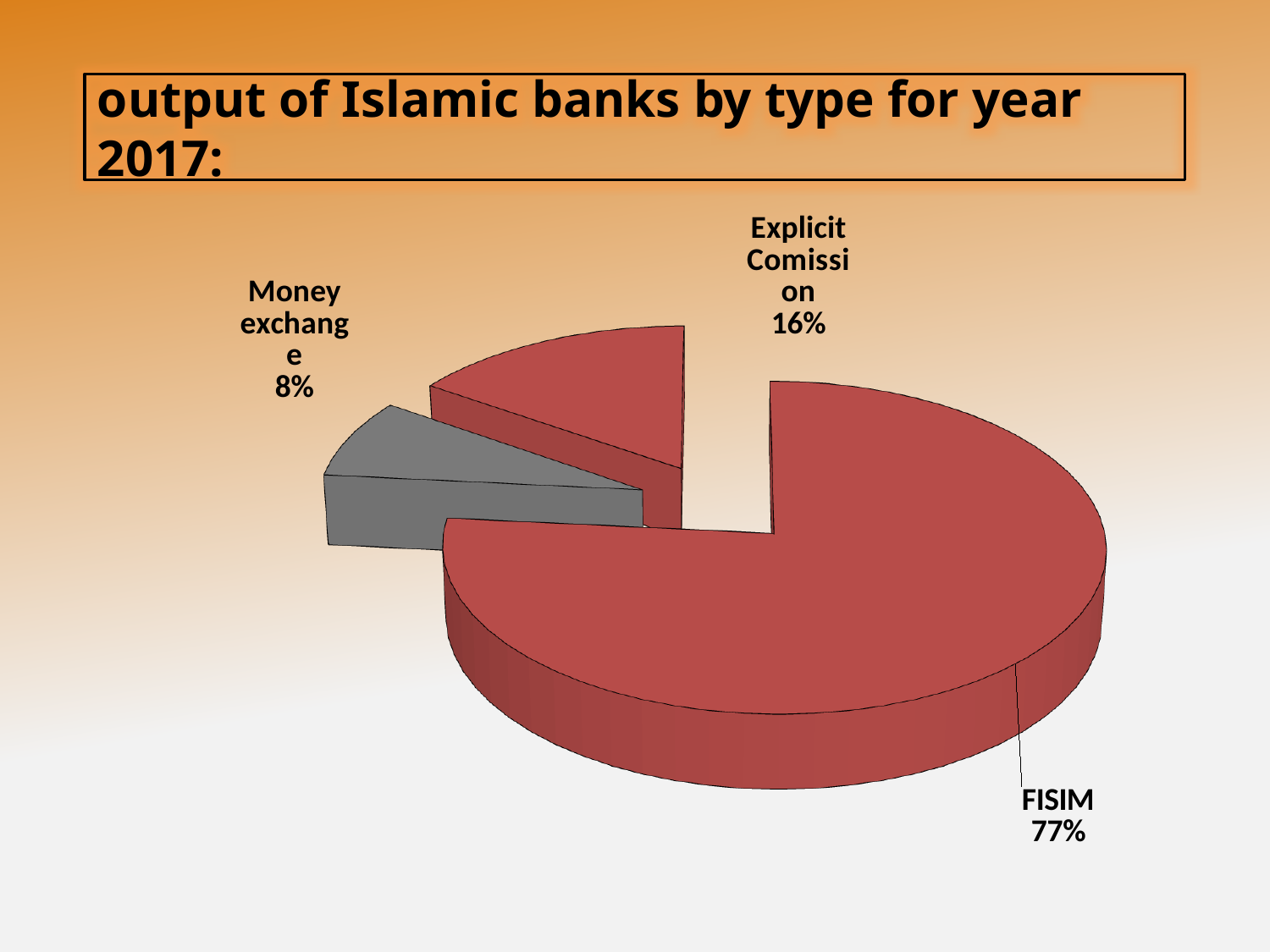
What share of the pie does Explicit Comission account for? 16% What is the difference in percentage points between the Explicit Comission share and the Money exchange share? 8 Which category has the smallest slice of the pie? Money exchange Which slice of the pie is coloured grey? Money exchange What is the title of the chart on the slide? output of Islamic banks by type for year 2017: Which category has the largest slice of the pie? FISIM Which is larger, the share for Explicit Comission or the share for Money exchange? Explicit Comission What share of the pie does Money exchange account for? 8% What is the difference in percentage points between the FISIM share and the Explicit Comission share? 61 What share of the pie does FISIM account for? 77% How many slices does the pie chart have? 3 What kind of chart is shown on the slide? Pie chart